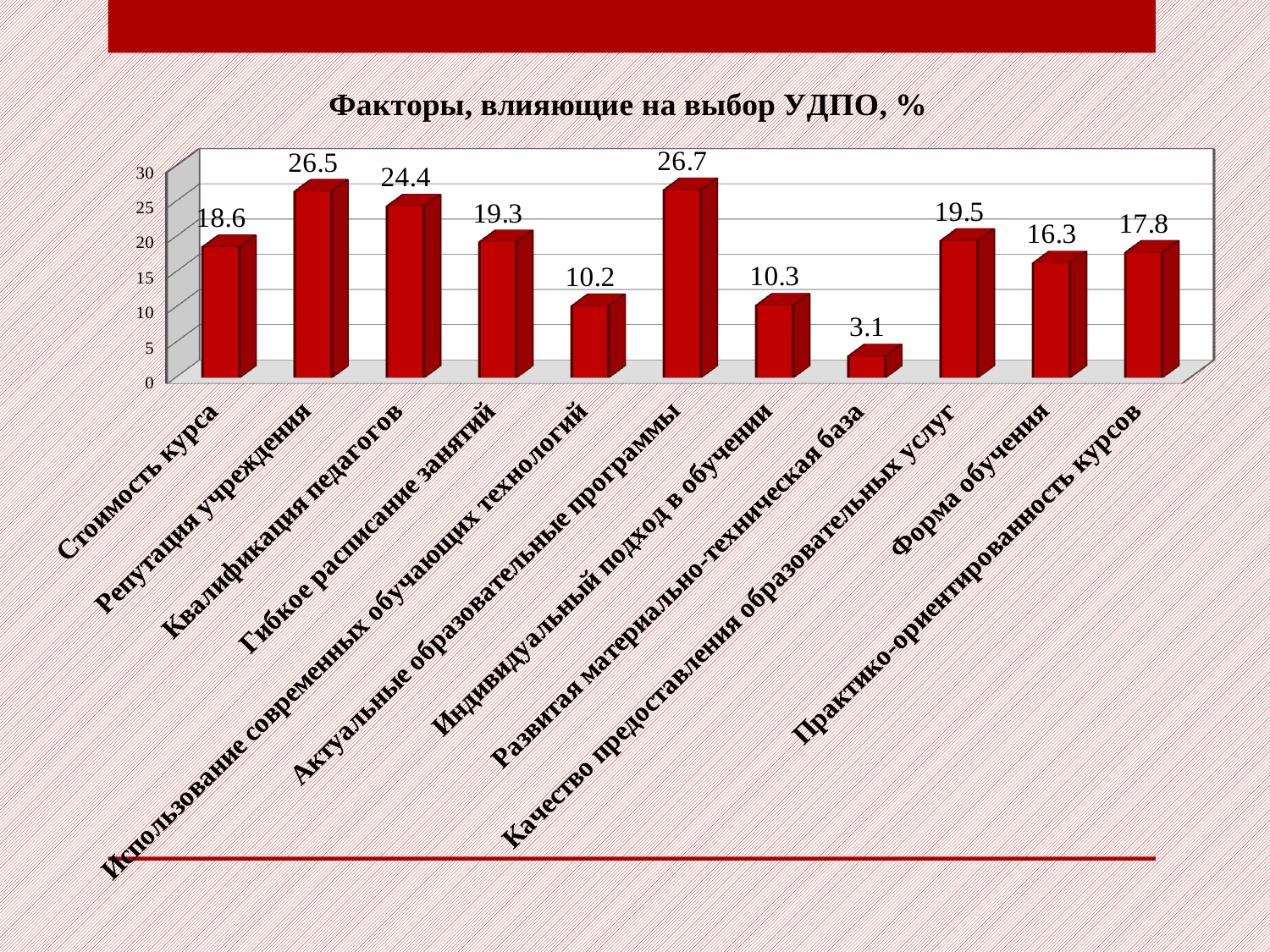
What is the value for Стоимость курса? 18.6 What is the difference between the values for Квалификация педагогов and Гибкое расписание занятий? 5.1 What is the value for Репутация учреждения? 26.5 Is the value for Индивидуальный подход в обучении greater or less than 15? less Which is larger: the value for Качество предоставления образовательных услуг or the value for Практико-ориентированность курсов? Качество предоставления образовательных услуг What kind of chart is shown on the slide? bar chart How many categories are shown in the chart? 11 What is the value for Форма обучения? 16.3 What is the value for Развитая материально-техническая база? 3.1 Which category has the lowest value? Развитая материально-техническая база What is the title of the chart? Факторы, влияющие на выбор УДПО, % Which category has the highest value? Актуальные образовательные программы